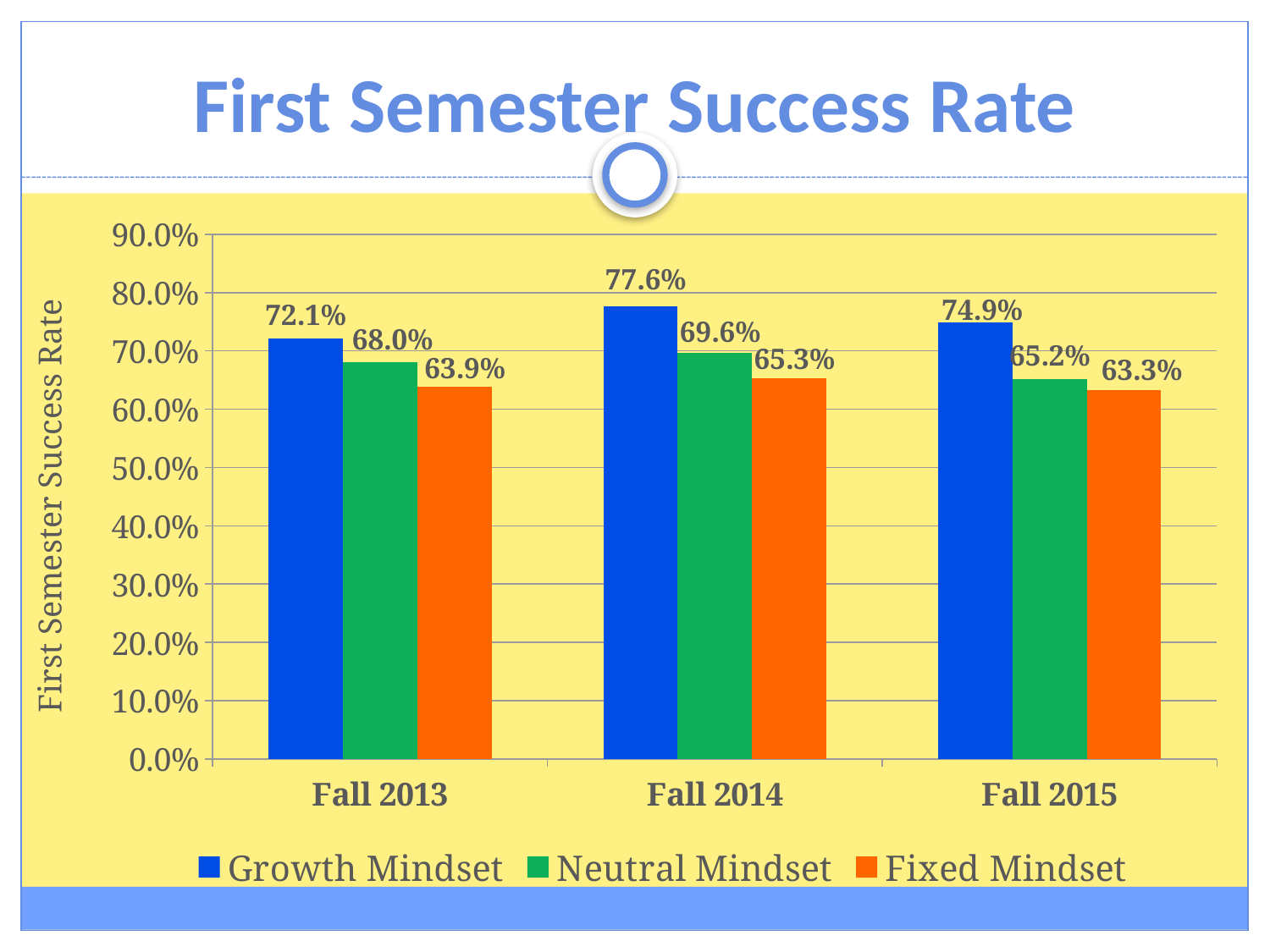
How many series does the legend list? 3 In which semester is the Growth Mindset success rate highest? Fall 2014 What is the first semester success rate for Growth Mindset in Fall 2014? 77.6% Which is larger in Fall 2013: the Neutral Mindset success rate or the Fixed Mindset success rate? Neutral Mindset What kind of chart is shown on the slide? bar chart How many semesters are shown on the x axis? 3 What is the first semester success rate for Neutral Mindset in Fall 2015? 65.2% What is the title of the chart? First Semester Success Rate What is the difference between the Growth Mindset and Fixed Mindset success rates in Fall 2014? 12.3% In which semester is the Fixed Mindset success rate lowest? Fall 2015 Is the Growth Mindset success rate in Fall 2015 greater or less than 70.0%? greater What is the first semester success rate for Fixed Mindset in Fall 2013? 63.9%